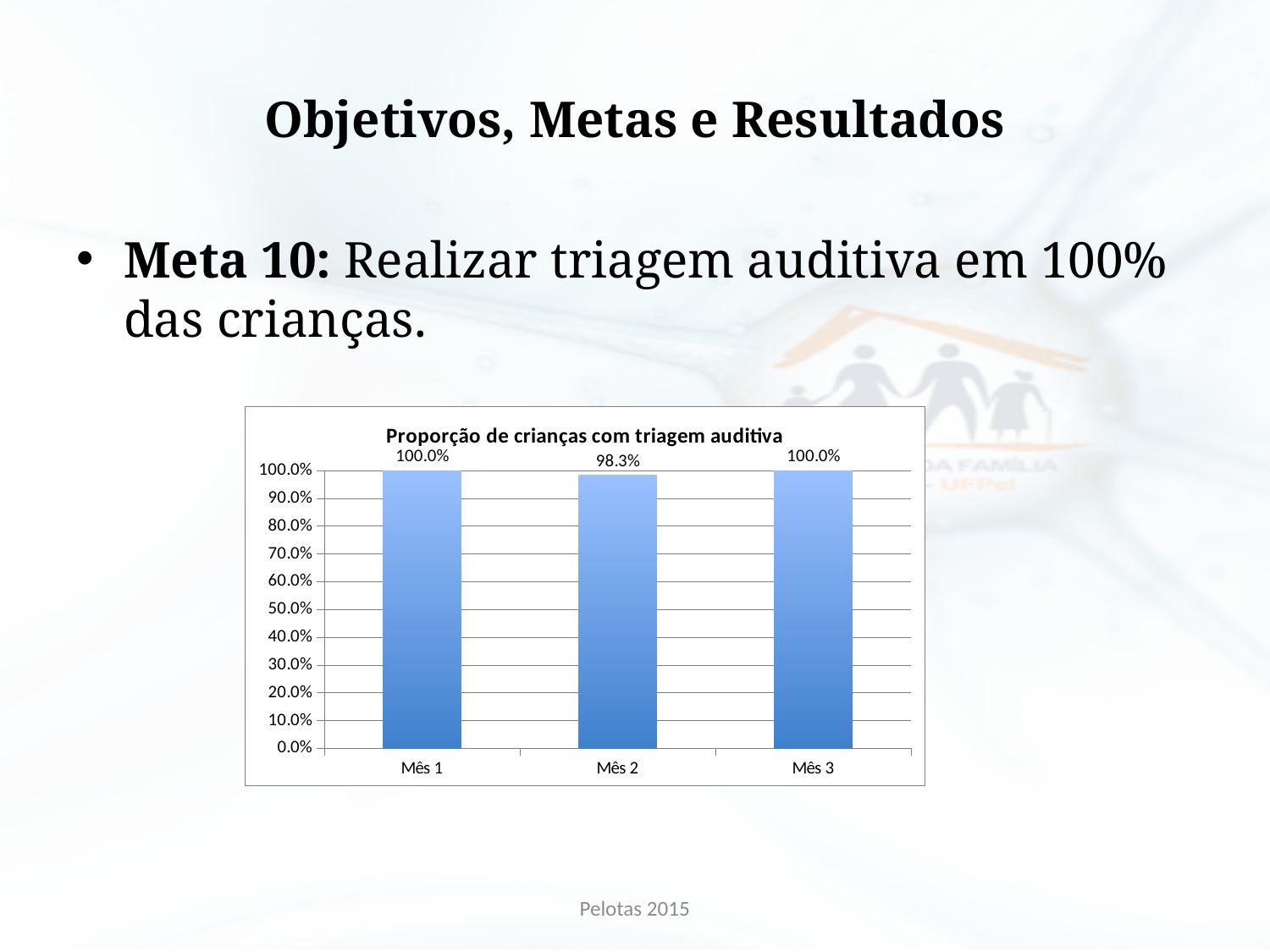
What is the title of the chart? Proporção de crianças com triagem auditiva Is the value for Mês 2 greater or less than 90.0%? greater What is the value for Mês 2? 98.3% What is the value for Mês 1? 100.0% Which month has the lowest value? Mês 2 What is the difference between the values for Mês 1 and Mês 2? 1.7% What is the highest value shown on the y axis? 100.0% What kind of chart is shown on the slide? bar chart Which is larger, the value for Mês 2 or the value for Mês 3? Mês 3 How many months are shown on the x axis? 3 What is the value for Mês 3? 100.0%